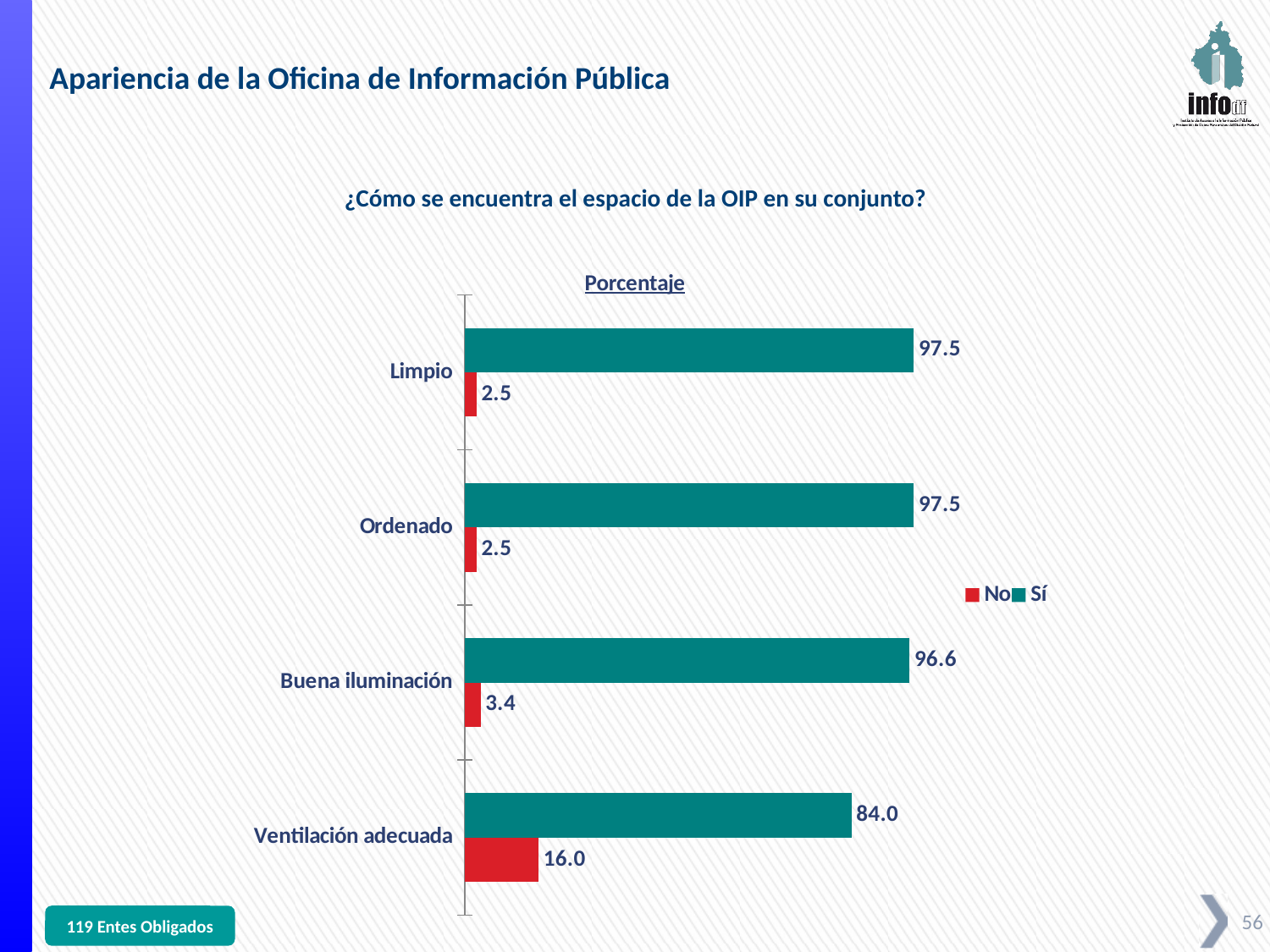
What is the 'Sí' value for Limpio? 97.5 Which is larger: the 'Sí' value for Buena iluminación or the 'Sí' value for Ventilación adecuada? Buena iluminación What is the difference between the 'Sí' and 'No' values for Ventilación adecuada? 68.0 Which category has the lowest 'Sí' value? Ventilación adecuada What kind of chart is shown on the slide? Bar chart What is the 'No' value for Ventilación adecuada? 16.0 Which category has the highest 'No' value? Ventilación adecuada How many categories are shown on the chart? 4 What is the difference between the 'No' value for Buena iluminación and the 'No' value for Limpio? 0.9 What is the 'No' value for Ordenado? 2.5 How many series does the legend list? 2 What is the 'Sí' value for Buena iluminación? 96.6